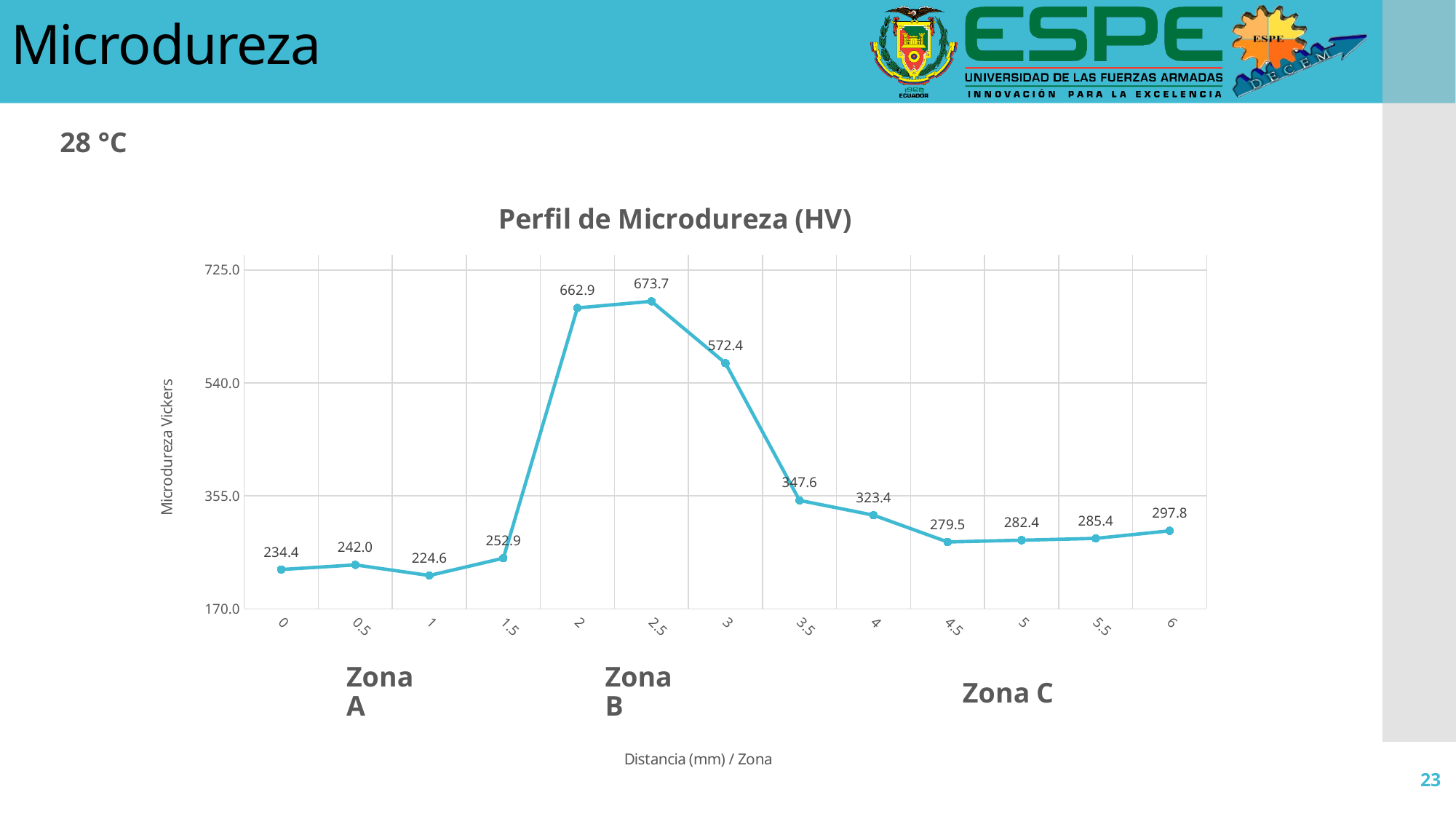
What is the microhardness value at a distance of 0 mm? 234.4 Which is larger, the microhardness at 3 mm or at 3.5 mm? 3 mm At which distance is the microhardness lowest? 1 What is the difference between the microhardness at 2.5 mm and at 2 mm? 10.8 What is the microhardness value at a distance of 4 mm? 323.4 What is the microhardness value at a distance of 2.5 mm? 673.7 What kind of chart is shown on the slide? line chart At which distance is the microhardness highest? 2.5 What is the title of the chart? Perfil de Microdureza (HV) Is the microhardness value at 1.5 mm greater or less than 355.0? less Do the values rise or fall from 3 mm to 4.5 mm? fall How many data points are plotted on the chart? 13